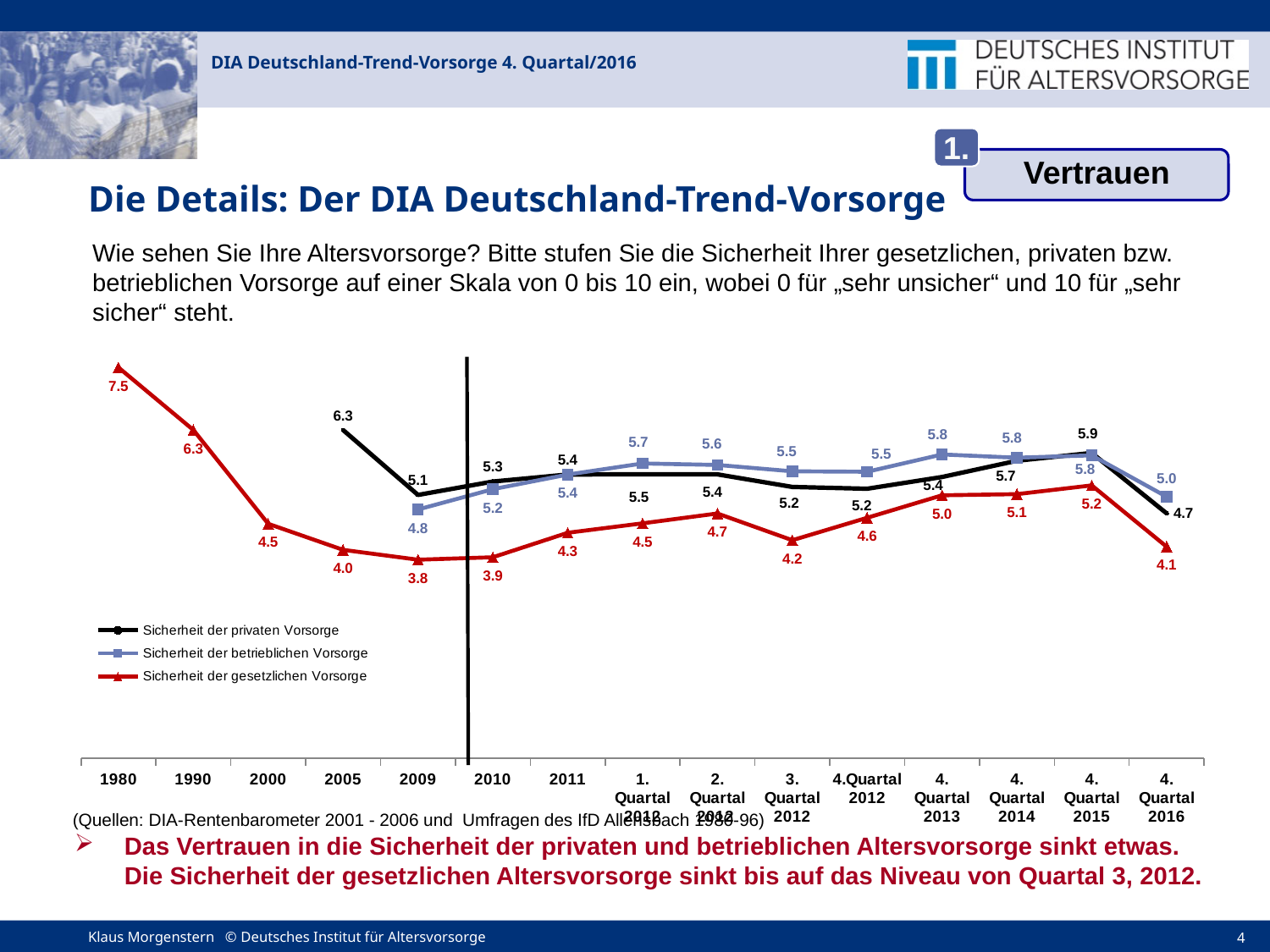
What type of chart is shown on the slide? line chart In which year or quarter is Sicherheit der gesetzlichen Vorsorge lowest? 2009 Which is larger in 4. Quartal 2016: Sicherheit der betrieblichen Vorsorge or Sicherheit der gesetzlichen Vorsorge? Sicherheit der betrieblichen Vorsorge What is the value for Sicherheit der privaten Vorsorge in 4. Quartal 2016? 4.7 What is the difference between Sicherheit der privaten Vorsorge and Sicherheit der gesetzlichen Vorsorge in 4. Quartal 2015? 0.7 Does Sicherheit der gesetzlichen Vorsorge rise or fall from 1980 to 2009? fall How many points are plotted for Sicherheit der gesetzlichen Vorsorge? 15 What is the value for Sicherheit der gesetzlichen Vorsorge in 3. Quartal 2012? 4.2 In which year or quarter is Sicherheit der privaten Vorsorge highest? 2005 What is the value for Sicherheit der betrieblichen Vorsorge in 4. Quartal 2013? 5.8 What is the value for Sicherheit der gesetzlichen Vorsorge in 1980? 7.5 How many series does the legend list? 3